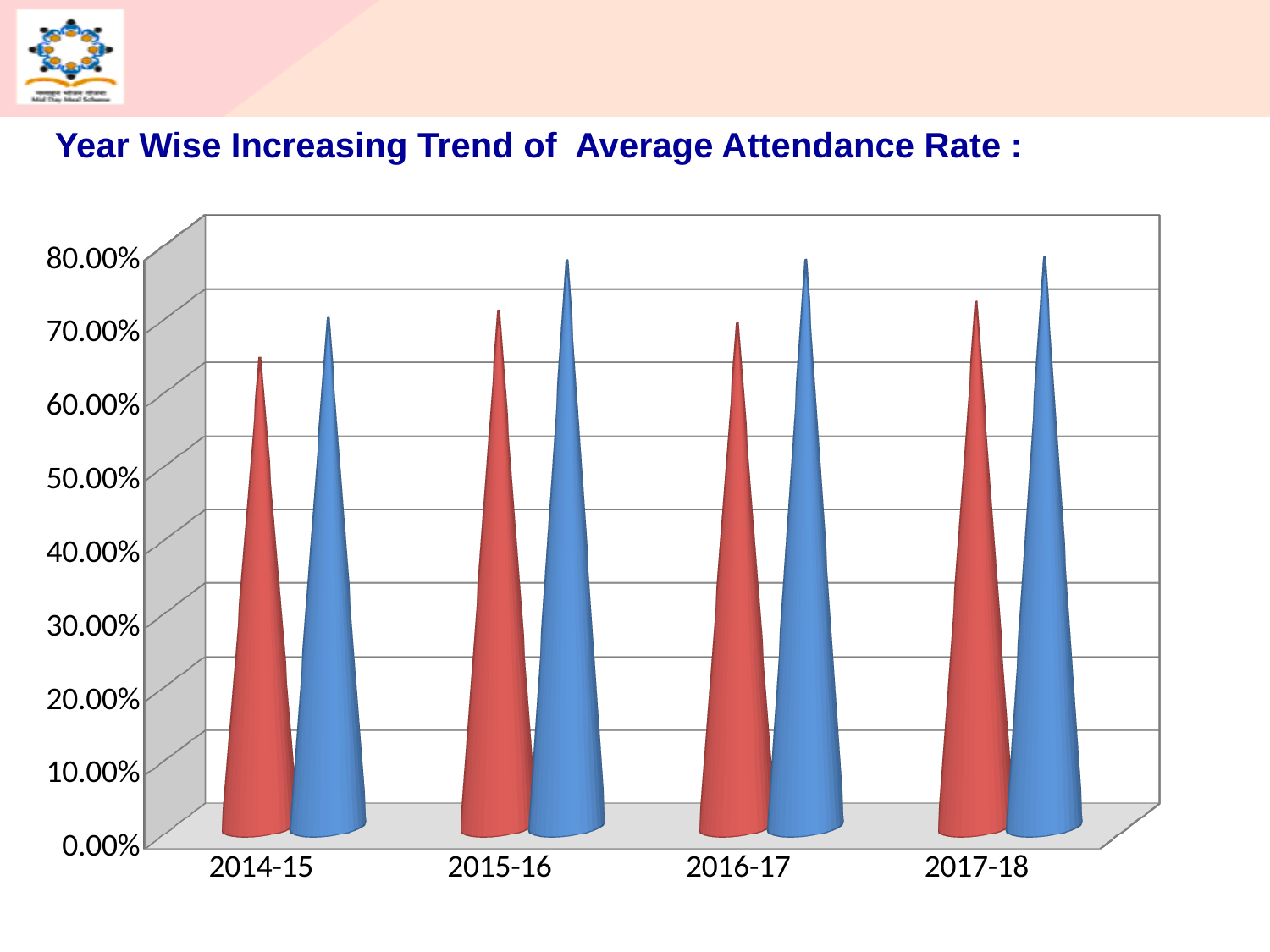
How many bars are plotted for each year? 2 In which year is the blue bar the lowest? 2014-15 What kind of chart is shown on the slide? bar chart How many year categories are shown on the x axis? 4 Is the value of the blue bar for 2015-16 greater or less than 70.00%? greater Is the value of the red bar for 2014-15 greater or less than 70.00%? less What is the title of the slide above the chart? Year Wise Increasing Trend of Average Attendance Rate : For 2016-17, which bar is higher, the red one or the blue one? the blue one Is the value of the blue bar for 2017-18 greater or less than 70.00%? greater In which year is the red bar the lowest? 2014-15 For 2014-15, which bar is higher, the red one or the blue one? the blue one